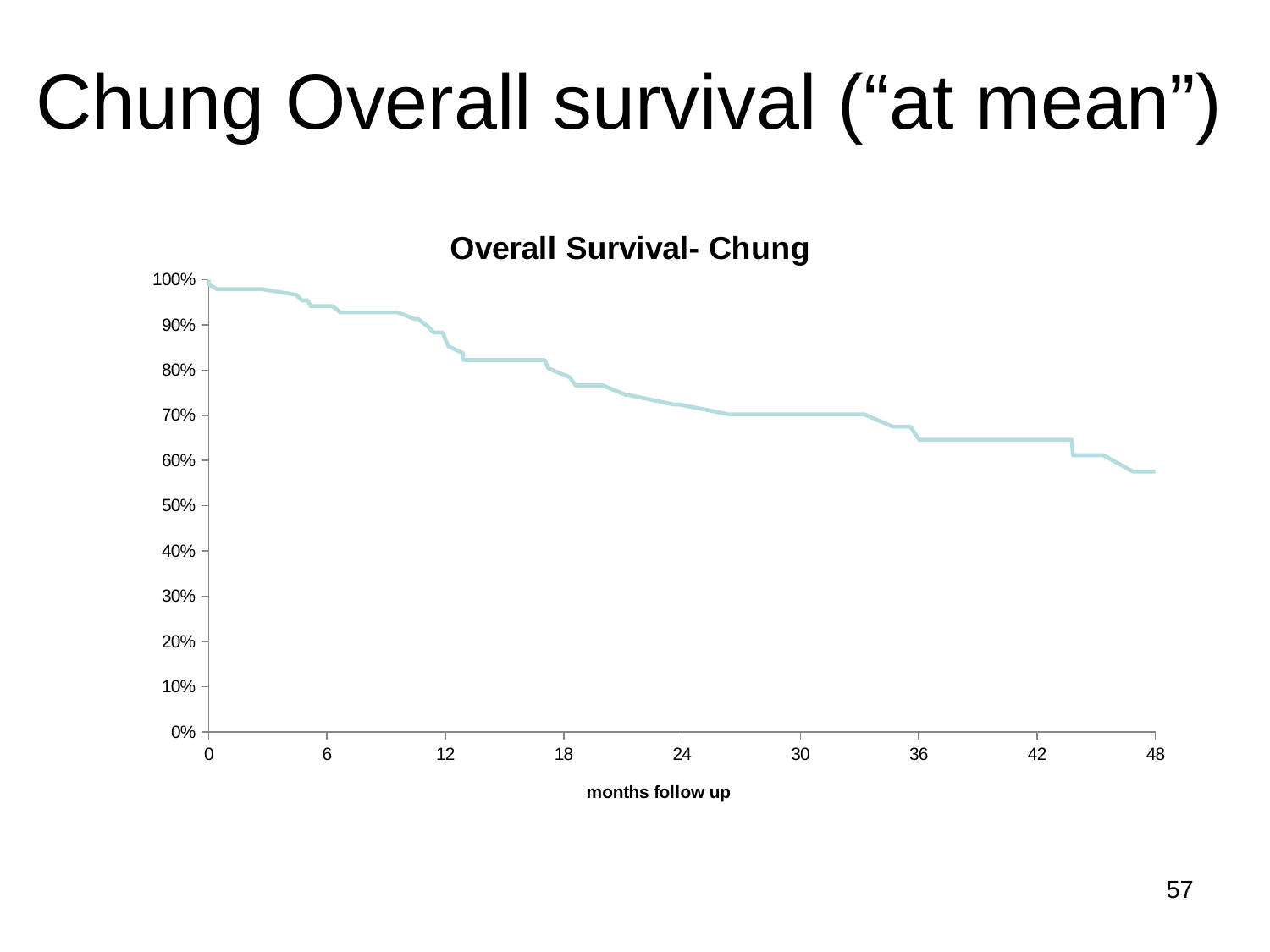
Which is higher, the overall survival at 12 months or at 36 months follow up? 12 months Is the overall survival at 12 months follow up greater or less than 80%? greater What is the overall survival value at 0 months follow up? 100% Is the overall survival at 6 months follow up greater or less than 90%? greater Is the overall survival at 48 months follow up greater or less than 60%? less What is the title of the chart? Overall Survival- Chung What is the label of the x axis? months follow up What type of chart is shown on the slide? line chart Does the survival curve rise or fall as months of follow up increase? fall